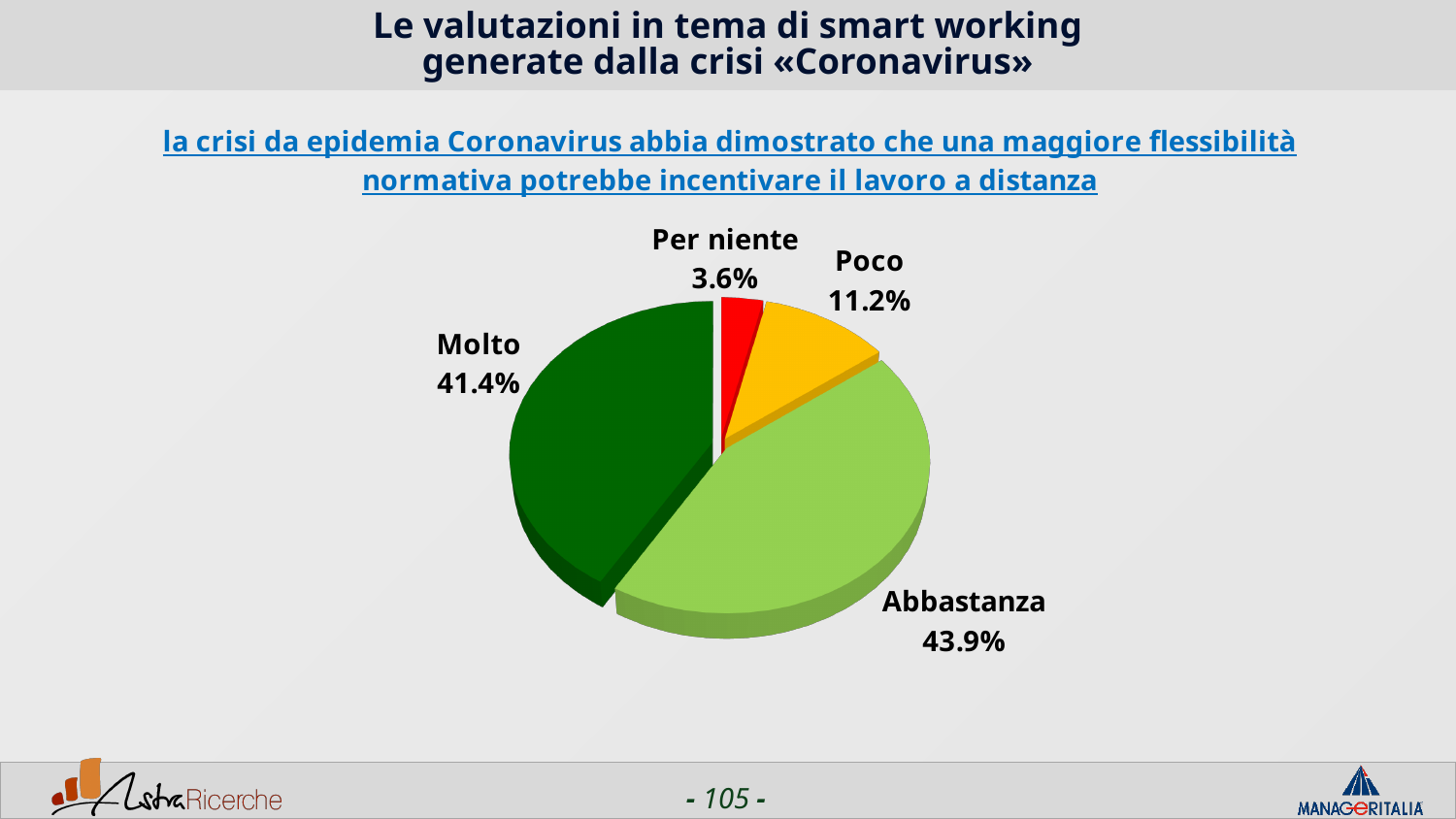
How many slices does the pie chart have? 4 Which category has the smallest share of the pie? Per niente What is the value for Molto? 41.4% What is the difference between the values for Abbastanza and Molto? 2.5% What is the value for Abbastanza? 43.9% What colour is the Per niente slice? red Which is larger, the value for Poco or the value for Per niente? Poco Which category has the largest share of the pie? Abbastanza What is the value for Per niente? 3.6% What kind of chart is shown on the slide? pie chart What is the difference between the values for Poco and Per niente? 7.6% What is the value for Poco? 11.2%